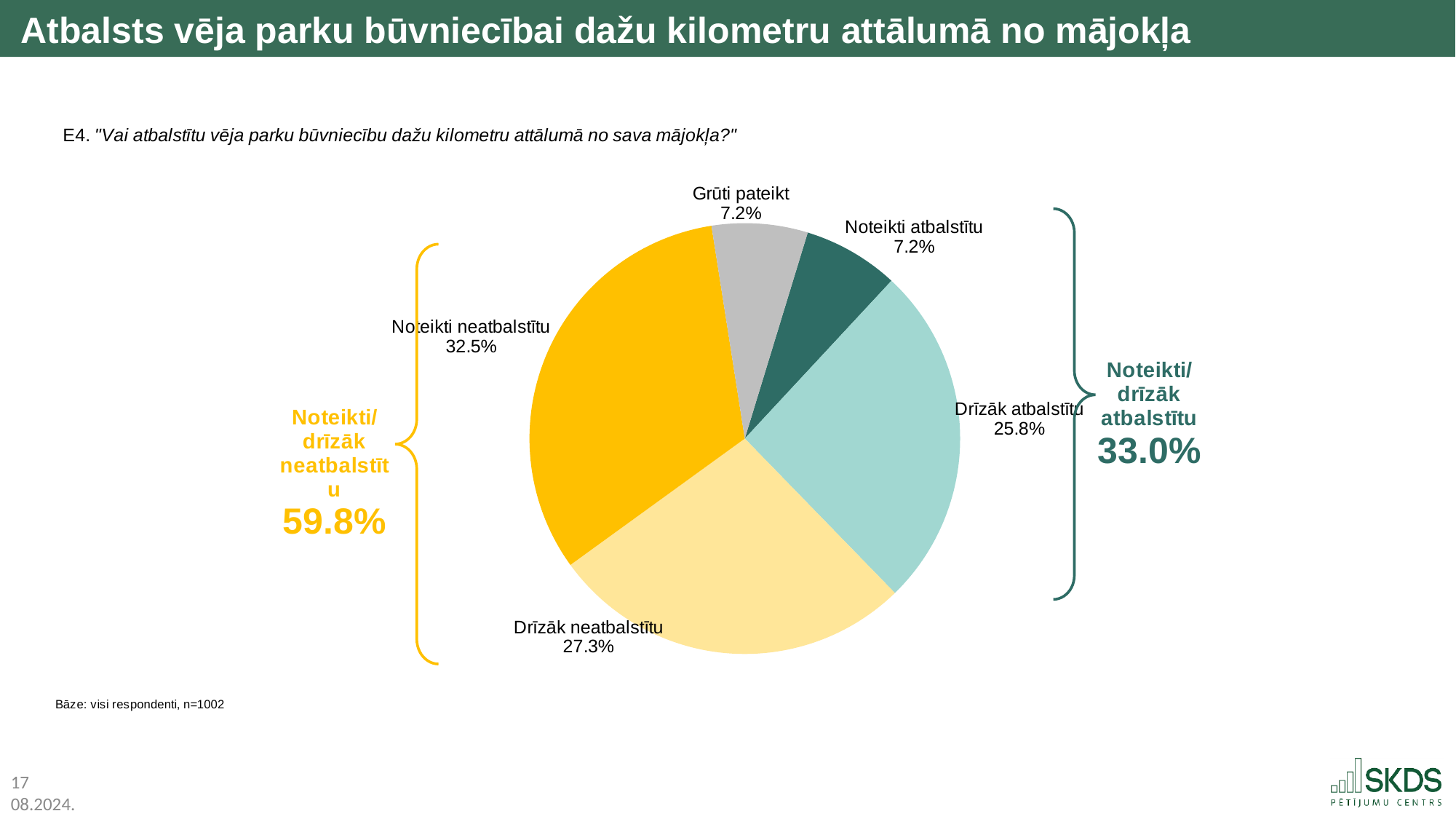
What combined share is shown for "Noteikti/drīzāk atbalstītu"? 33.0% What is the base (number of respondents) stated below the chart? n=1002 What share of respondents answered "Drīzāk atbalstītu"? 25.8% What kind of chart is shown on the slide? pie chart What share of respondents answered "Noteikti neatbalstītu"? 32.5% What combined share is shown for "Noteikti/drīzāk neatbalstītu"? 59.8% What share of respondents answered "Noteikti atbalstītu"? 7.2% How many slices does the pie chart have? 5 What share of respondents answered "Grūti pateikt"? 7.2% Which response has the largest slice of the pie? Noteikti neatbalstītu Which is larger: the share for "Drīzāk neatbalstītu" or for "Drīzāk atbalstītu"? Drīzāk neatbalstītu What is the difference between the shares for "Noteikti neatbalstītu" and "Drīzāk neatbalstītu"? 5.2%